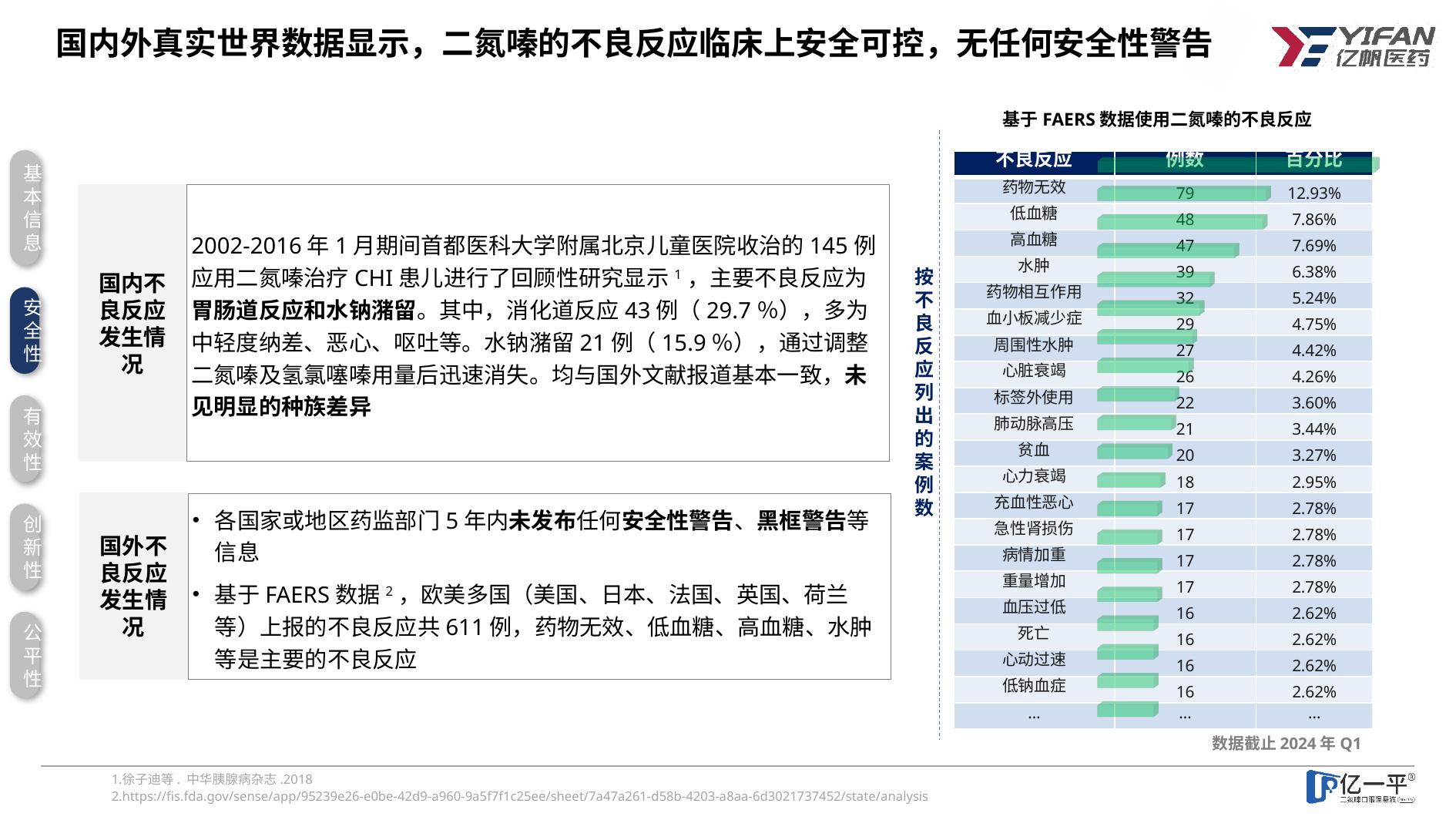
In the chart '基于 FAERS 数据使用二氮嗪的不良反应', do the case counts rise or fall going down the list from 药物无效 to 低钠血症? fall In the chart '基于 FAERS 数据使用二氮嗪的不良反应', how many cases are listed for 水肿? 39 In the chart '基于 FAERS 数据使用二氮嗪的不良反应', what is the difference in cases between 药物无效 and 低血糖? 31 What kind of chart is used in '基于 FAERS 数据使用二氮嗪的不良反应'? bar chart In the chart '基于 FAERS 数据使用二氮嗪的不良反应', which has more cases, 贫血 or 心力衰竭? 贫血 In the chart '基于 FAERS 数据使用二氮嗪的不良反应', how many cases (例数) are listed for 药物无效? 79 In the chart '基于 FAERS 数据使用二氮嗪的不良反应', how many named adverse reactions are listed (excluding the '...' row)? 20 In the chart '基于 FAERS 数据使用二氮嗪的不良反应', what percentage is shown for 肺动脉高压? 3.44% In the chart '基于 FAERS 数据使用二氮嗪的不良反应', what is the difference in cases between 高血糖 and 水肿? 8 In the chart '基于 FAERS 数据使用二氮嗪的不良反应', what percentage (百分比) is shown for 低血糖? 7.86% In the chart '基于 FAERS 数据使用二氮嗪的不良反应', which adverse reaction has the highest number of cases? 药物无效 In the chart '基于 FAERS 数据使用二氮嗪的不良反应', which has more cases, 血小板减少症 or 心脏衰竭? 血小板减少症